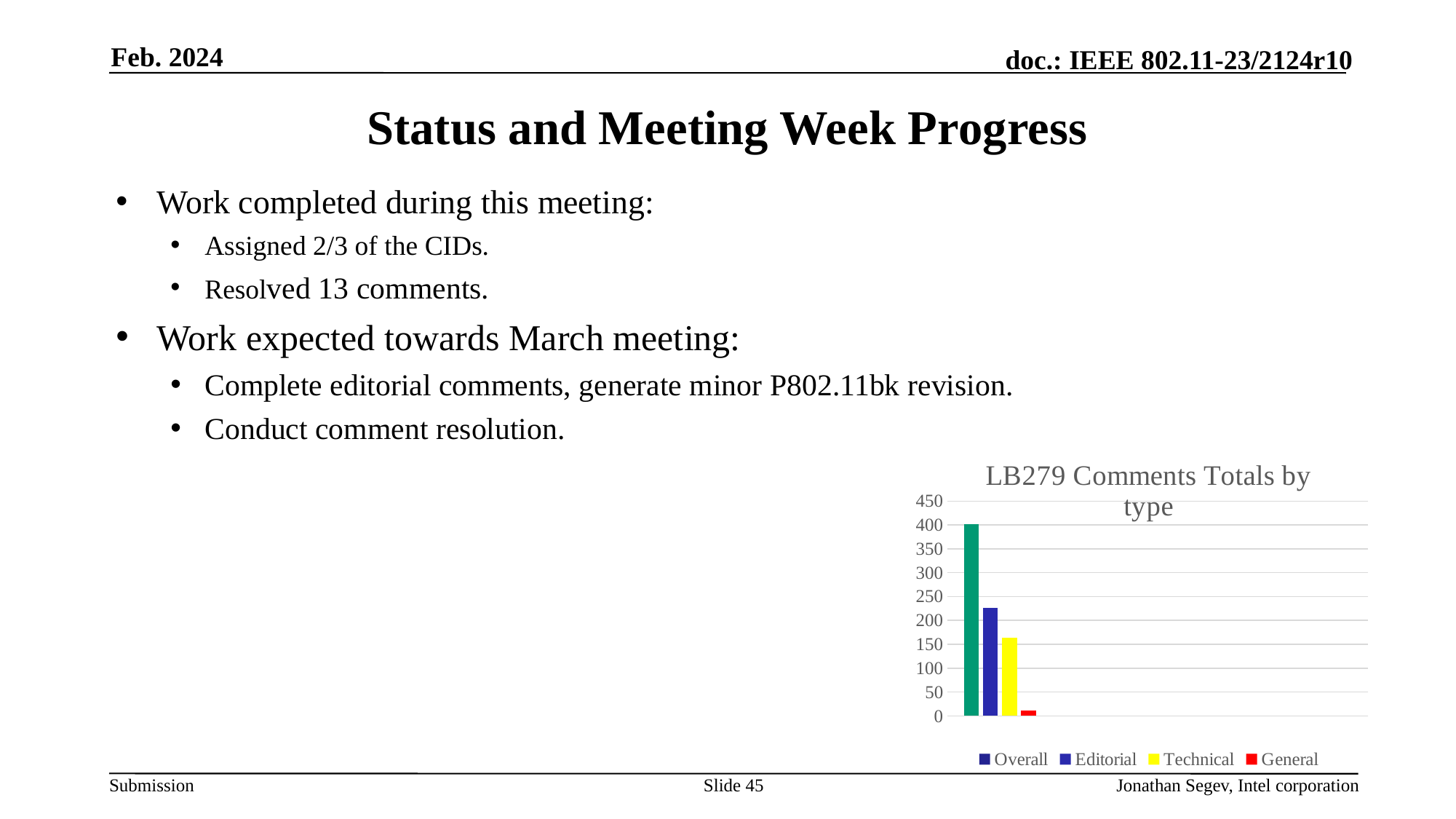
Is the value for Editorial greater or less than 200? greater What is the title of the chart? LB279 Comments Totals by type How many series does the chart legend list? 4 Is the value for Overall greater or less than 350? greater Which series has the lowest value in the chart? General Is the value for General greater or less than 50? less Which series has the highest value in the chart? Overall What kind of chart is shown on the slide? bar chart Which is larger, the value for Editorial or the value for Technical? Editorial Which is larger, the value for Technical or the value for General? Technical What colour is the bar for the Technical series? yellow